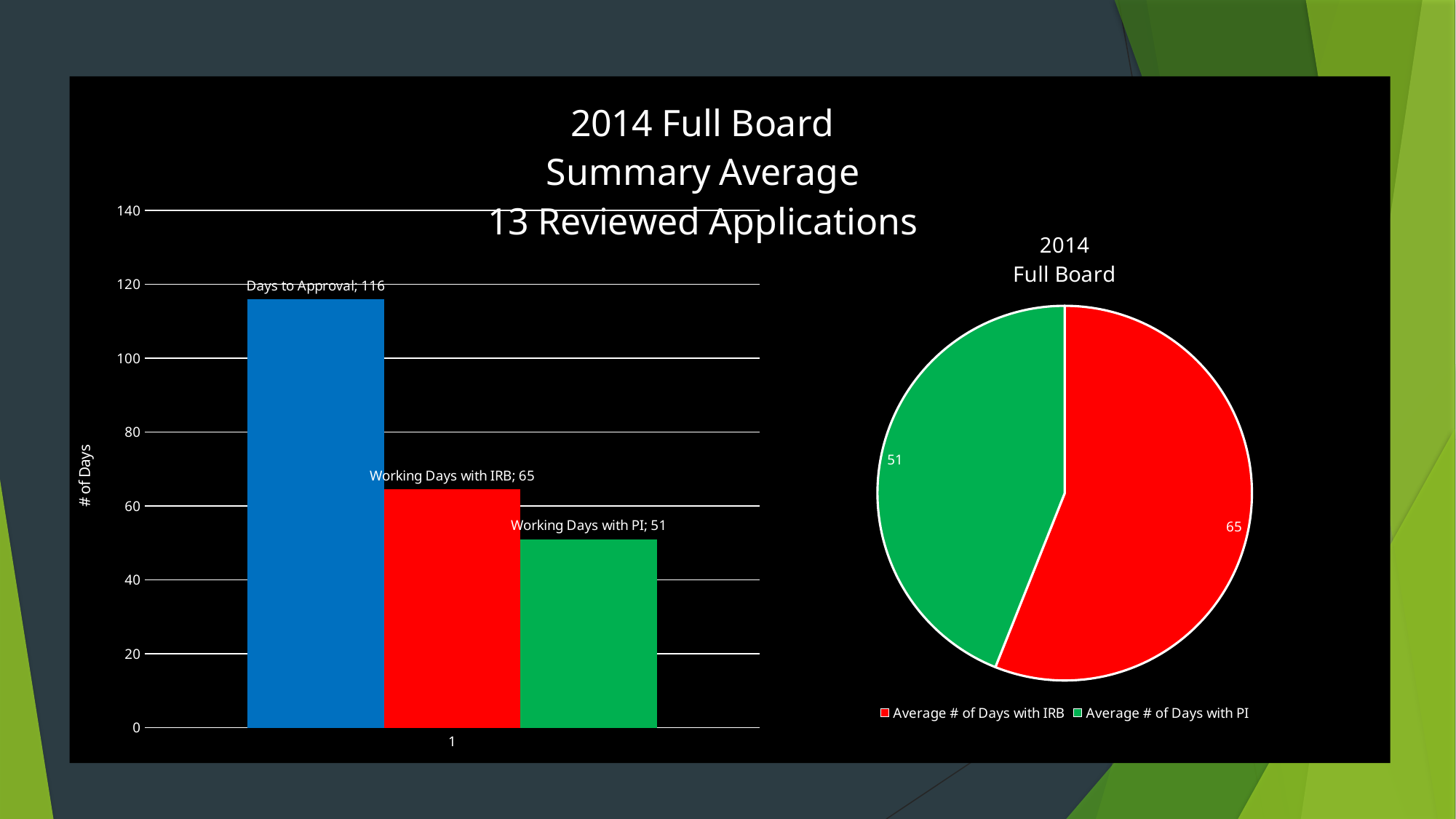
In the bar chart on the left, what is the difference between Days to Approval and Working Days with IRB? 51 In the pie chart titled '2014 Full Board', what colour is the Average # of Days with PI slice? green In the bar chart on the left, how many bars are plotted? 3 In the pie chart titled '2014 Full Board', what is the value for Average # of Days with IRB? 65 In the bar chart on the left, what is the value for Working Days with IRB? 65 In the bar chart on the left, what is the value for Working Days with PI? 51 In the bar chart on the left, what is the value for Days to Approval? 116 In the bar chart on the left, which is larger: Working Days with IRB or Working Days with PI? Working Days with IRB In the pie chart titled '2014 Full Board', how many entries does the legend list? 2 In the bar chart on the left, which series has the highest value? Days to Approval In the bar chart on the left, which series has the lowest value? Working Days with PI What kind of chart is the chart on the left? bar chart